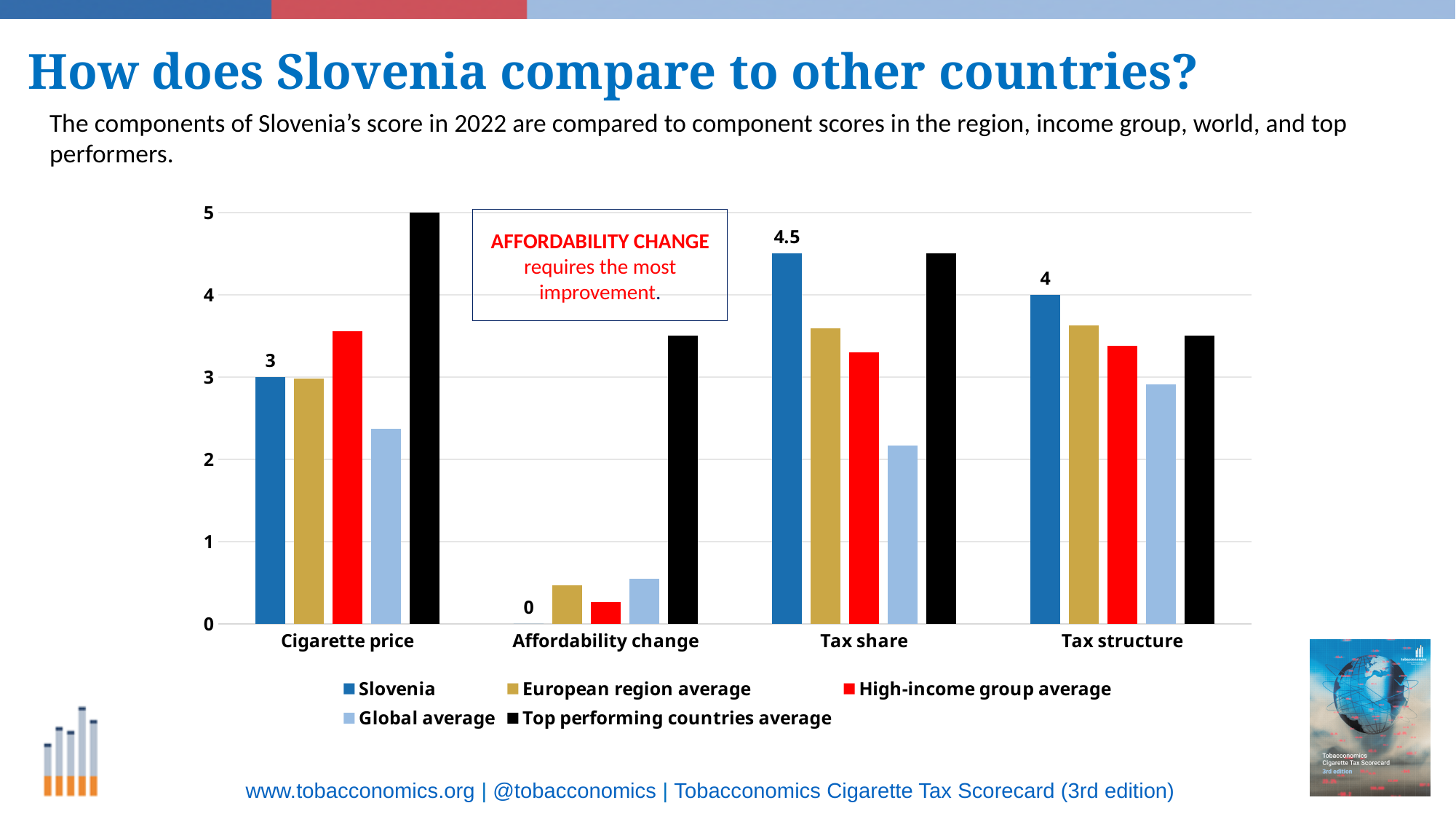
In which component does Slovenia have its lowest score? Affordability change What is the difference between Slovenia's Tax share score and its Tax structure score? 0.5 How many series does the legend list? 5 Is the Top performing countries average value for Affordability change greater or less than 3? greater What is Slovenia's score for Tax structure? 4 What is Slovenia's score for Affordability change? 0 Is the Global average value for Cigarette price greater or less than 3? less For Cigarette price, which is larger: Slovenia or the Top performing countries average? Top performing countries average In which component does Slovenia have its highest score? Tax share What type of chart is shown on the slide? Bar chart What is Slovenia's score for Cigarette price? 3 What is Slovenia's score for Tax share? 4.5